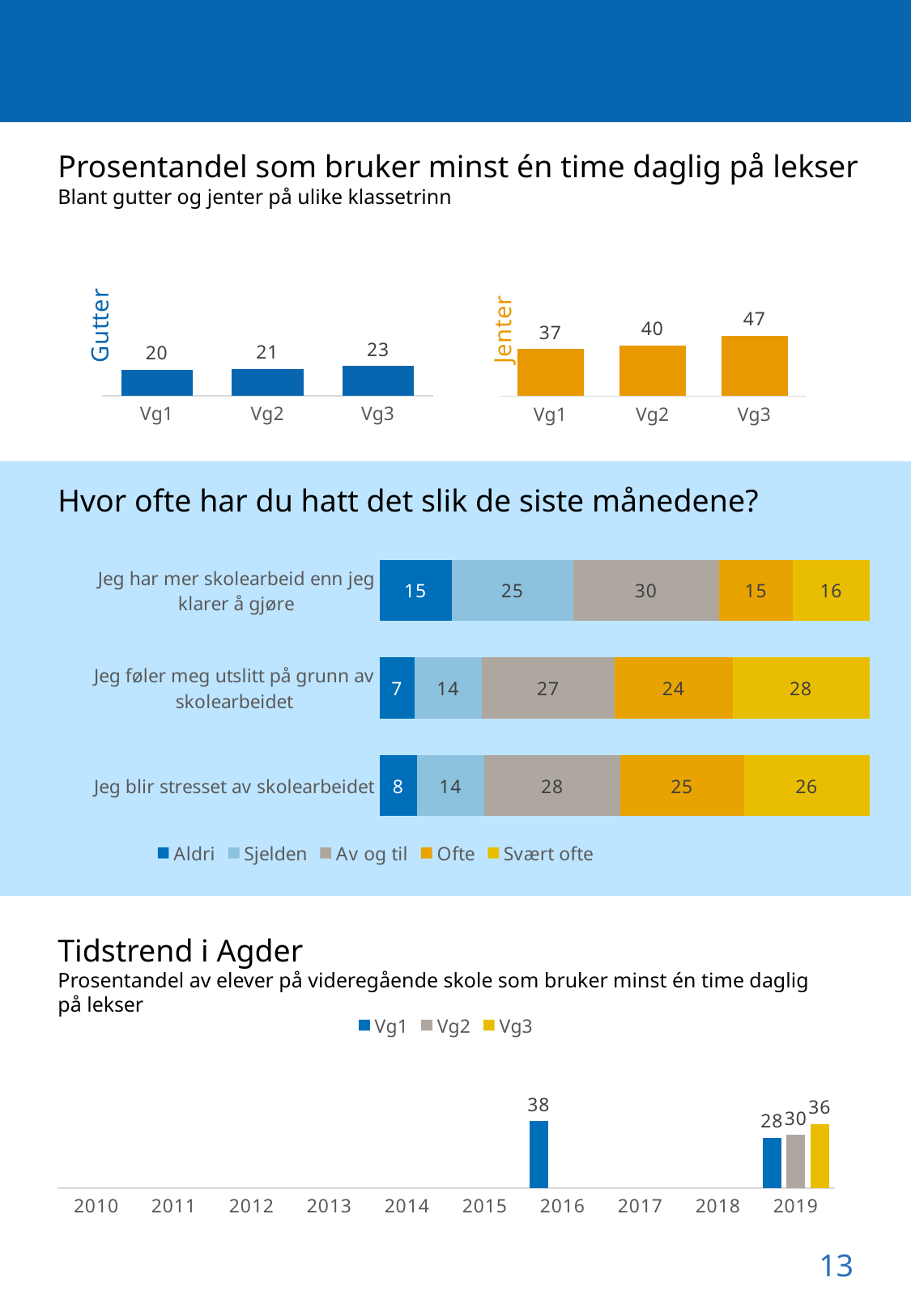
In the 'Tidstrend i Agder' chart, what is the difference between the Vg3 and Vg1 values for 2019? 8 In the chart 'Hvor ofte har du hatt det slik de siste månedene?', what is the total of the bar for 'Jeg føler meg utslitt på grunn av skolearbeidet'? 100 In the chart 'Hvor ofte har du hatt det slik de siste månedene?', how many series does the legend list? 5 What kind of chart is the 'Tidstrend i Agder' chart? bar chart In the 'Jenter' chart, which category has the highest value? Vg3 In the 'Tidstrend i Agder' chart, what is the Vg1 value for 2016? 38 In the 'Gutter' chart, do the values rise or fall from Vg1 to Vg3? rise In the chart 'Hvor ofte har du hatt det slik de siste månedene?', which statement has the lowest 'Aldri' value? Jeg føler meg utslitt på grunn av skolearbeidet In the 'Jenter' chart, what is the difference between the values for Vg3 and Vg1? 10 Comparing the 'Gutter' and 'Jenter' charts, which has the larger value for Vg2? Jenter In the 'Gutter' chart, what is the value for Vg3? 23 In the chart 'Hvor ofte har du hatt det slik de siste månedene?', what is the 'Av og til' value for 'Jeg blir stresset av skolearbeidet'? 28